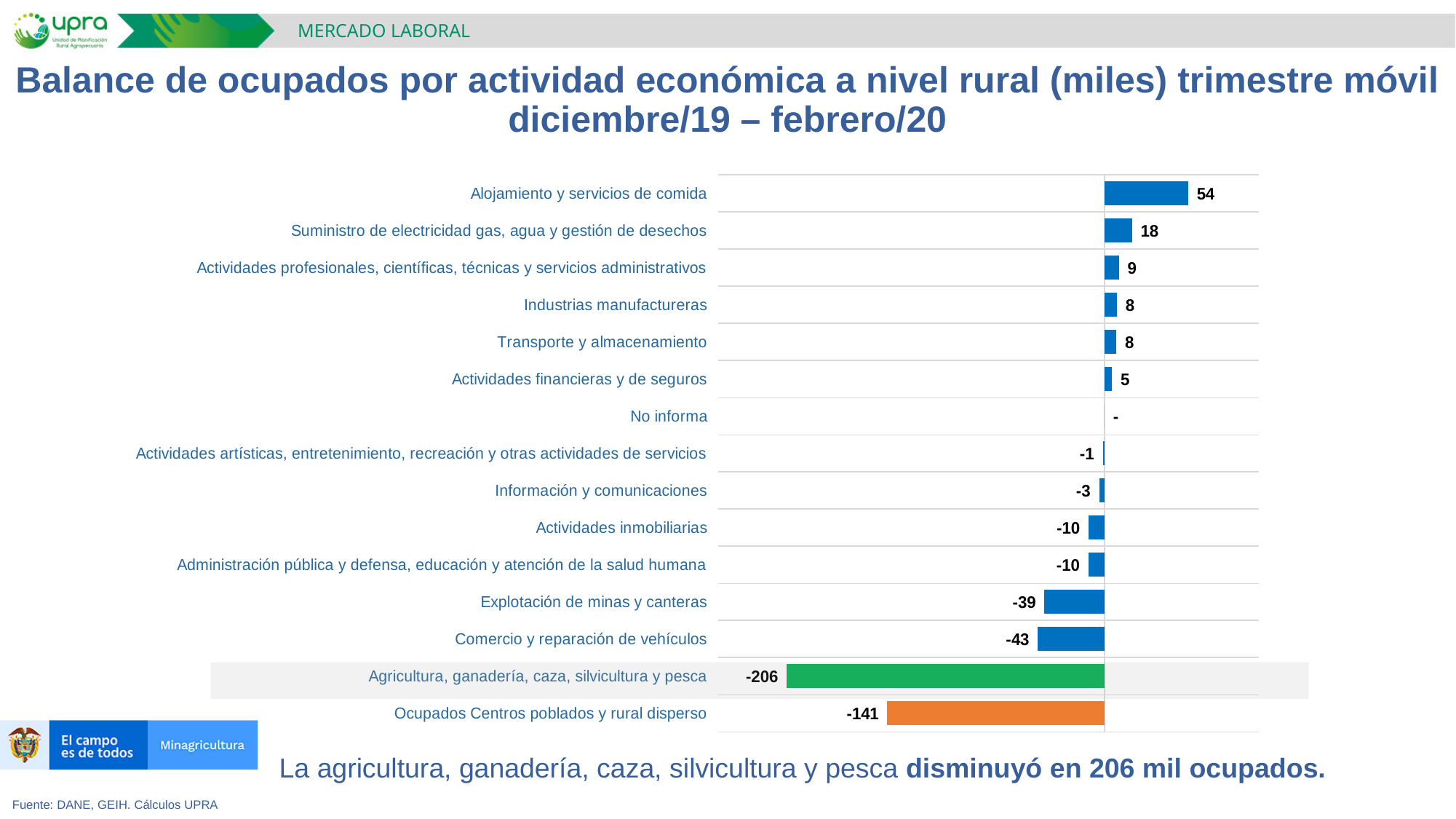
Which category has the lowest value? Agricultura, ganadería, caza, silvicultura y pesca What is the value for Agricultura, ganadería, caza, silvicultura y pesca? -206 What is the value for Comercio y reparación de vehículos? -43 What is the difference between the values for Alojamiento y servicios de comida and Suministro de electricidad gas, agua y gestión de desechos? 36 Which is larger in absolute terms, the value for Explotación de minas y canteras or the value for Comercio y reparación de vehículos? Comercio y reparación de vehículos What colour is the bar for Ocupados Centros poblados y rural disperso? Orange Which category has the highest value? Alojamiento y servicios de comida What is the value for Suministro de electricidad gas, agua y gestión de desechos? 18 What kind of chart is shown on the slide? Bar chart What is the value for Alojamiento y servicios de comida? 54 How many categories are shown in the chart? 15 What is the value for Ocupados Centros poblados y rural disperso? -141